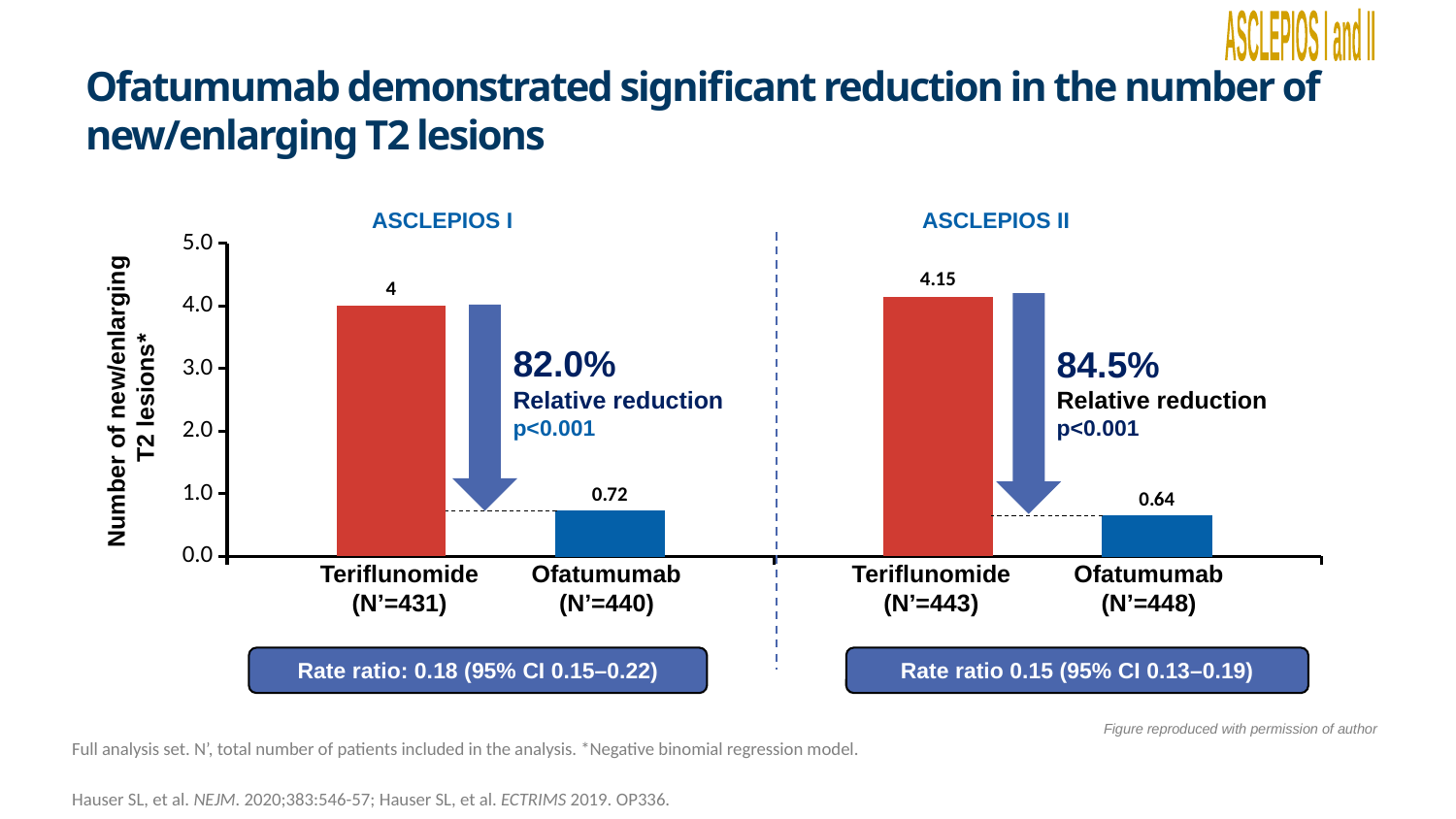
What kind of chart is used to show the number of new/enlarging T2 lesions in ASCLEPIOS I? bar chart In the ASCLEPIOS I chart, what is the difference in the number of new/enlarging T2 lesions between Teriflunomide and Ofatumumab? 3.28 In the ASCLEPIOS II chart, what is the number of new/enlarging T2 lesions for Ofatumumab? 0.64 In the ASCLEPIOS II chart, what is the difference in the number of new/enlarging T2 lesions between Teriflunomide and Ofatumumab? 3.51 Is the Teriflunomide value in the ASCLEPIOS II chart larger or smaller than the Teriflunomide value in the ASCLEPIOS I chart? larger In the ASCLEPIOS I chart, which treatment has the higher number of new/enlarging T2 lesions? Teriflunomide In the ASCLEPIOS I chart, what is the number of new/enlarging T2 lesions for Ofatumumab? 0.72 What relative reduction is shown in the ASCLEPIOS II chart? 84.5% In the ASCLEPIOS II chart, which treatment has the lower number of new/enlarging T2 lesions? Ofatumumab In the ASCLEPIOS II chart, what is the number of new/enlarging T2 lesions for Teriflunomide? 4.15 In the ASCLEPIOS I chart, what is the number of new/enlarging T2 lesions for Teriflunomide? 4 How many treatment categories are shown in the ASCLEPIOS I chart? 2